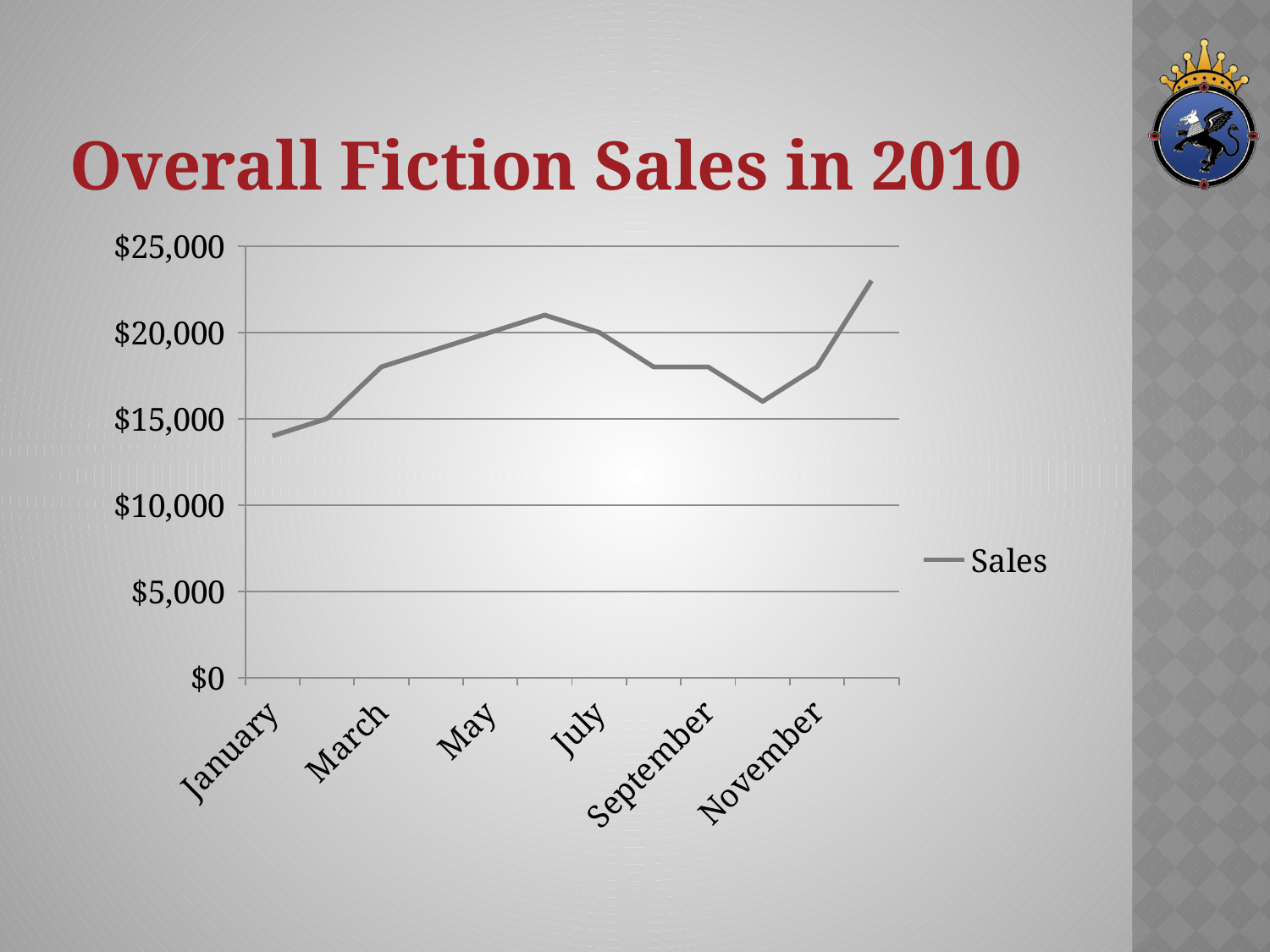
How many series does the legend list? 1 Is the sales value for September greater or less than $20,000? less What is the title of the chart? Overall Fiction Sales in 2010 Is the sales value for December greater or less than $20,000? greater Which month has the highest sales value? December Which month has the lowest sales value? January Which is larger, the sales value for July or the sales value for November? July Do sales rise or fall from January to May? rise What kind of chart is shown on the slide? Line chart What is the name of the series shown in the legend? Sales Is the sales value for March greater or less than $15,000? greater